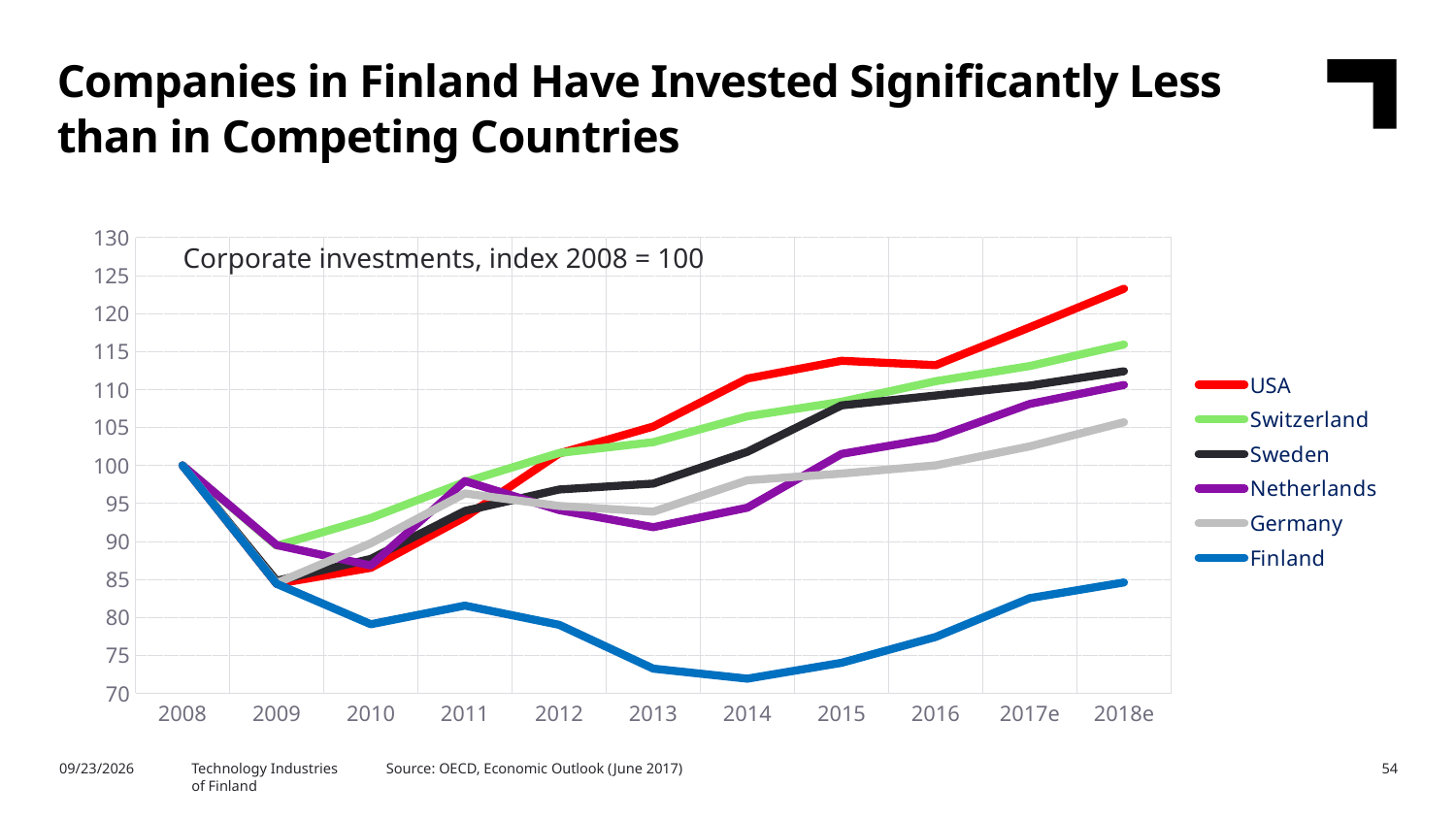
Which country has the highest index value in 2018e? USA How many years are shown along the x axis? 11 What kind of chart is shown on the slide? line chart Does the Finland line rise or fall from 2008 to 2014? fall How many series does the legend list? 6 Is the value for Finland in 2014 greater or less than 75? less Is the value for USA in 2018e greater or less than 120? greater Which is larger in 2016, the value for USA or the value for Finland? USA Which country has the lowest index value in 2018e? Finland What subtitle is printed inside the chart area? Corporate investments, index 2008 = 100 Which country has the lowest index value in 2010? Finland What is the index value for Finland in 2008? 100